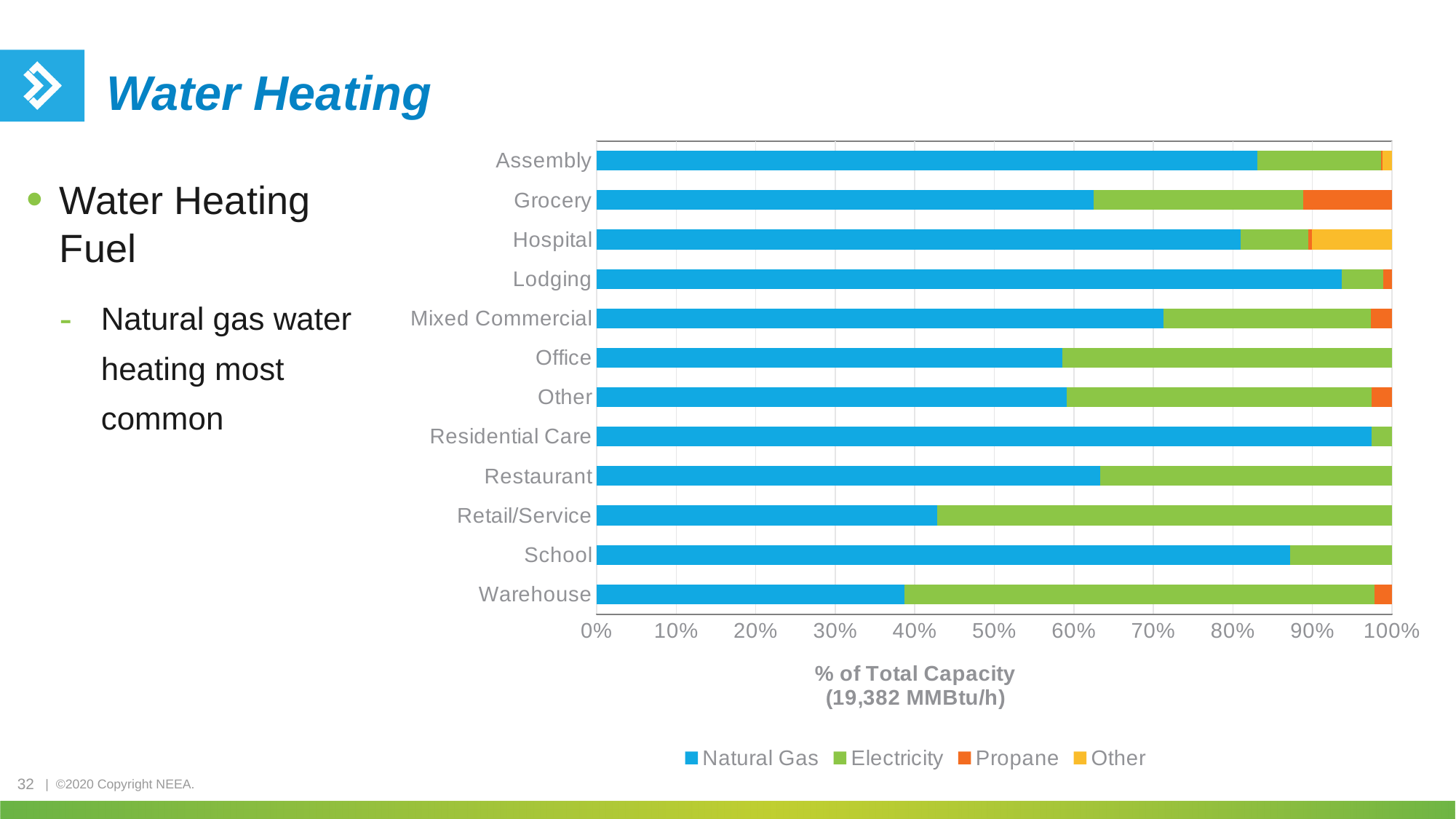
Is the Natural Gas share for Lodging greater or less than 90%? greater What is the x-axis title of the chart? % of Total Capacity (19,382 MMBtu/h) Is the Natural Gas share for Retail/Service greater or less than 50%? less Is the Natural Gas share for Residential Care greater or less than 90%? greater How many building-type categories are plotted on the chart? 12 Which has a larger Natural Gas share, Hospital or Office? Hospital Which category has the highest Natural Gas share of water heating capacity? Residential Care How many series does the chart legend list? 4 Which category has the lowest Natural Gas share of water heating capacity? Warehouse Which has a larger Electricity share, Retail/Service or Lodging? Retail/Service What kind of chart is shown on the slide? Stacked bar chart